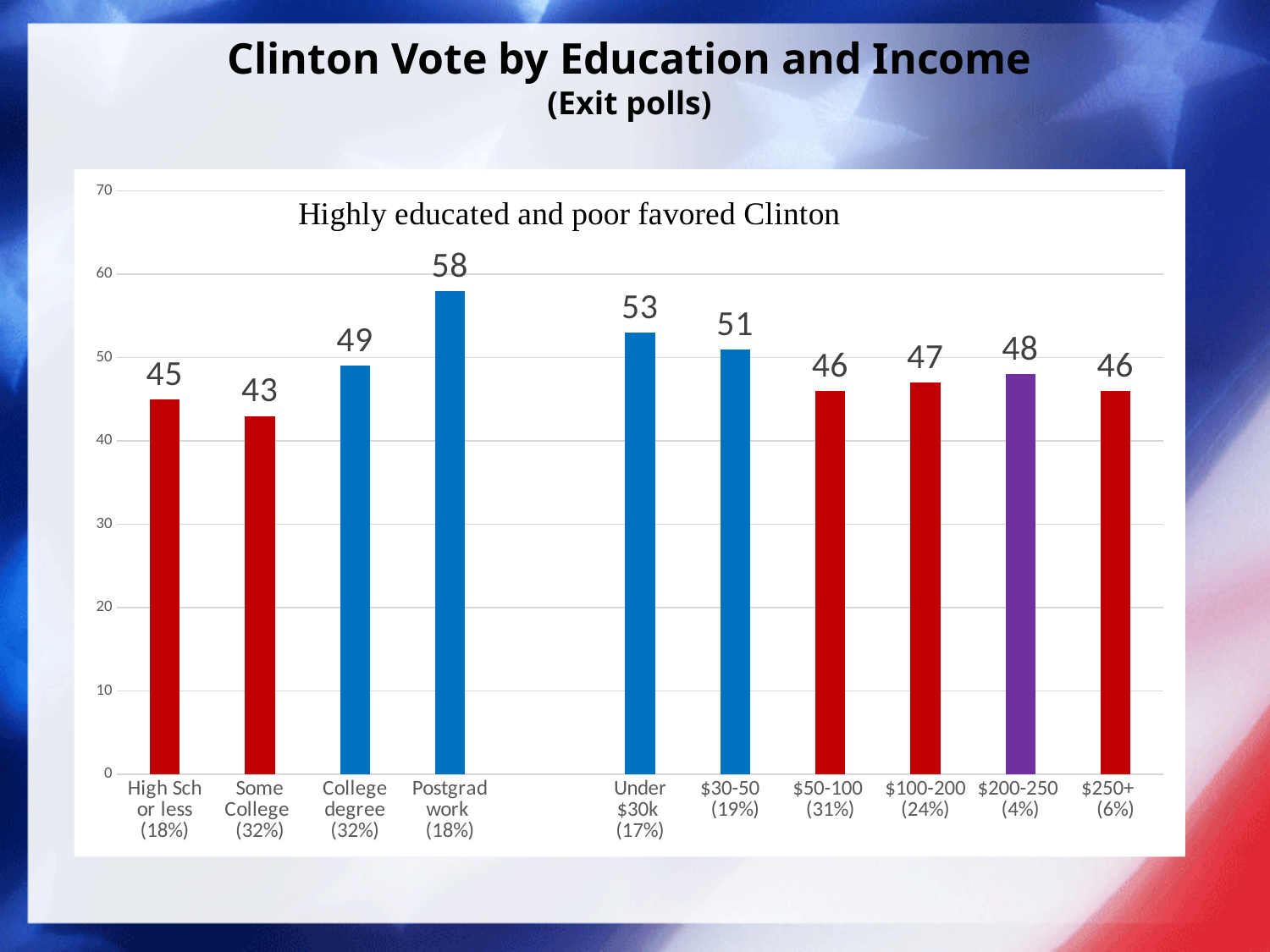
What is the difference between the values for Postgrad work (18%) and High Sch or less (18%)? 13 What is the value for Under $30k (17%)? 53 What is the value for Postgrad work (18%)? 58 What is the title of the chart? Clinton Vote by Education and Income (Exit polls) Which is larger, the value for Under $30k (17%) or the value for $30-50 (19%)? Under $30k (17%) What kind of chart is shown on the slide? bar chart Which category has the lowest value? Some College (32%) Is the value for College degree (32%) greater or less than 40? greater How many categories are plotted on the chart? 10 Which category has the highest value? Postgrad work (18%) What is the value for Some College (32%)? 43